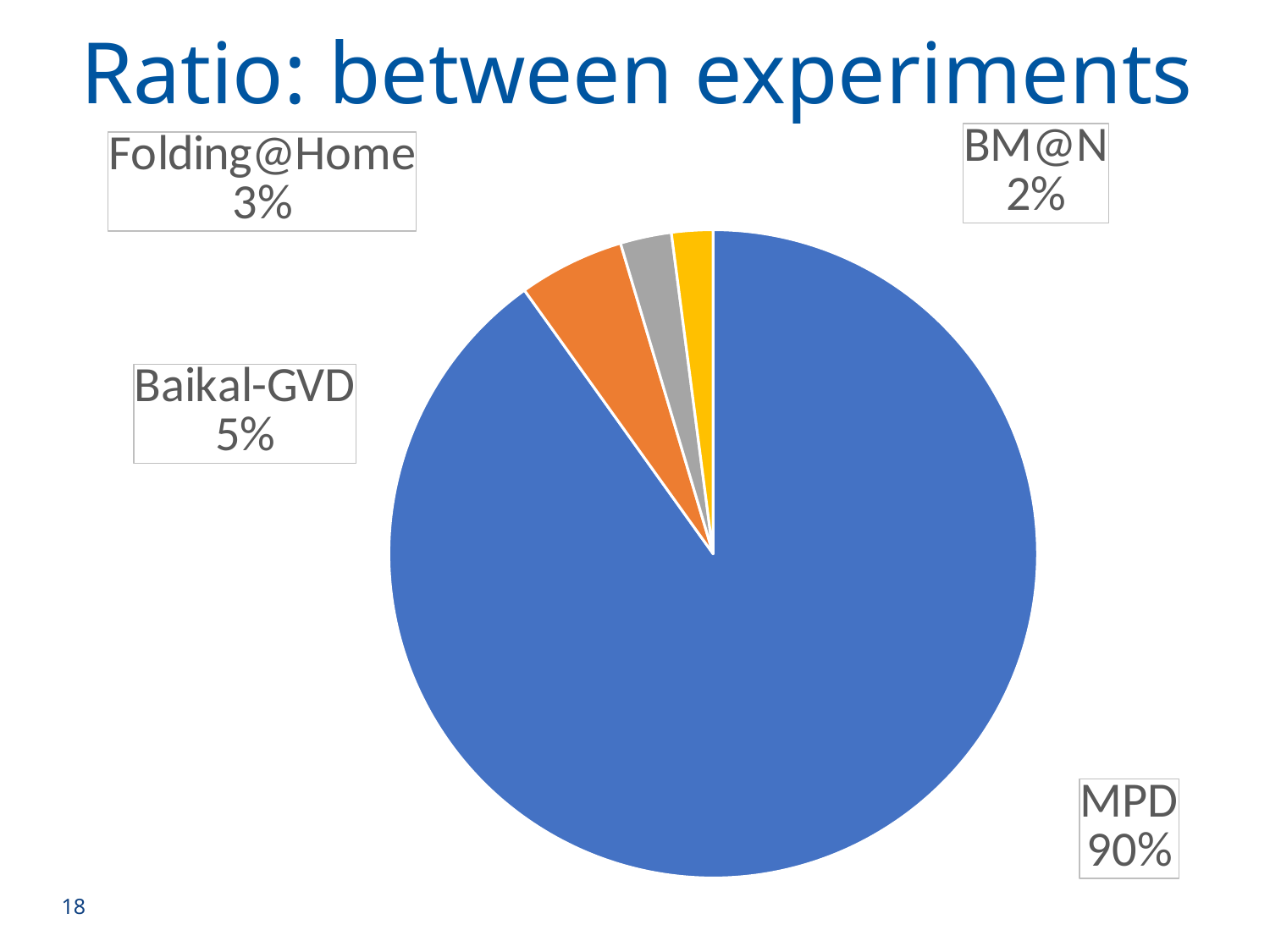
What is the difference in percentage points between the Baikal-GVD share and the Folding@Home share? 2 What is the title of the slide containing the chart? Ratio: between experiments What share of the pie does Folding@Home have? 3% What is the difference in percentage points between the MPD share and the Baikal-GVD share? 85 Which experiment has the largest share of the pie? MPD What share of the pie does MPD have? 90% How many experiments are shown as slices in the pie chart? 4 Which has a larger share, Folding@Home or BM@N? Folding@Home Which experiment has the smallest share of the pie? BM@N What share of the pie does Baikal-GVD have? 5% What kind of chart is shown on the slide? Pie chart What share of the pie does BM@N have? 2%